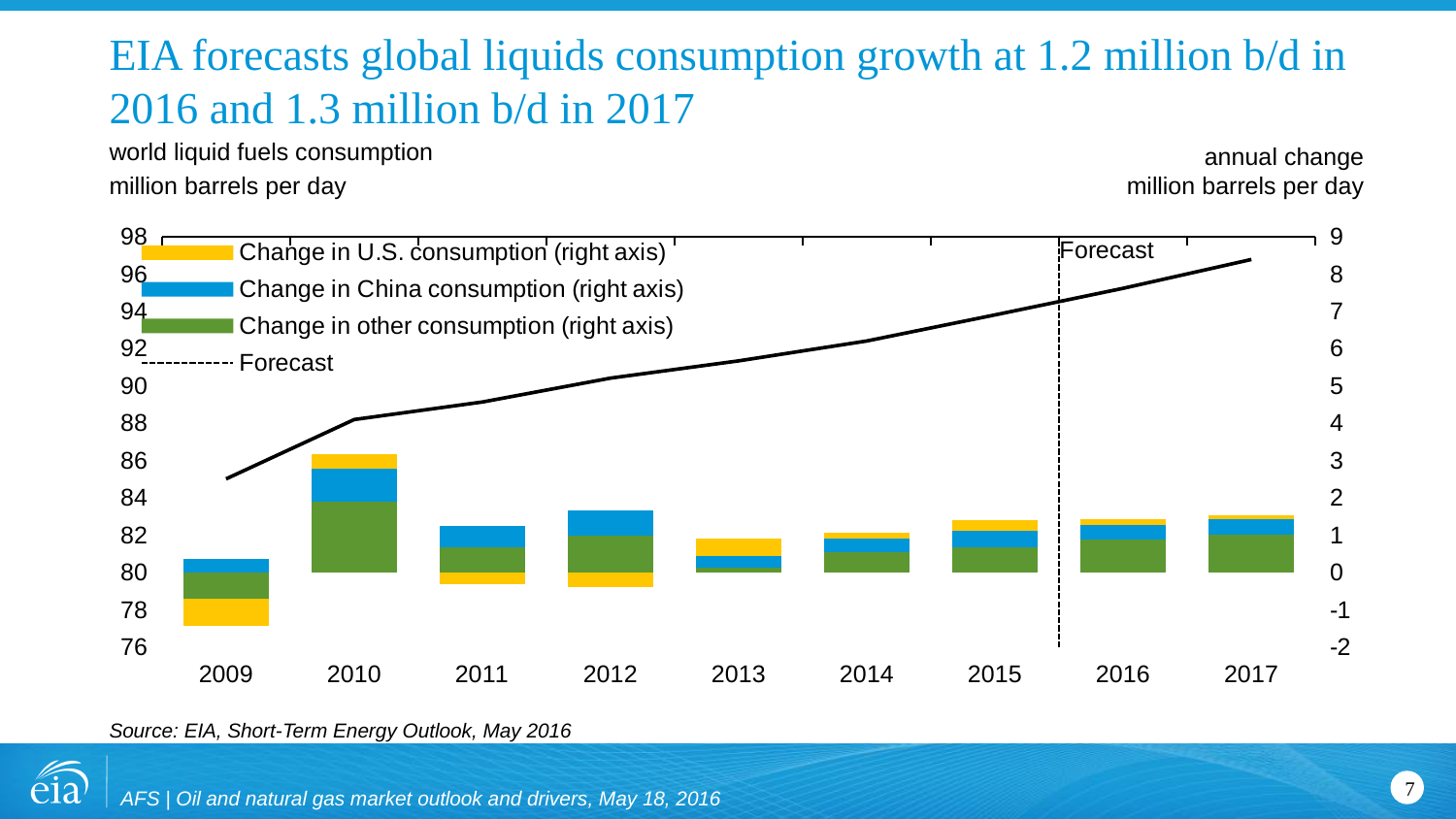
Which year is the only one where the change in U.S. consumption bar is clearly negative and the stacked bar extends below -1 on the right axis? 2009 How many years are shown along the x axis of the chart? 9 Does the world liquid fuels consumption line rise or fall from 2009 to 2017? Rises Is the world liquid fuels consumption line value for 2009 greater or less than 86 million barrels per day? less Which year has the tallest positive stacked bar for annual change in consumption? 2010 Is the world liquid fuels consumption line value for 2017 greater or less than 96 million barrels per day? greater Which years on the chart are marked as forecast years? 2016 and 2017 Which year has the higher world liquid fuels consumption line value, 2011 or 2012? 2012 What kind of chart is shown on the slide? A combination bar and line chart (stacked bars with a line) Is the world liquid fuels consumption line value for 2015 greater or less than 92 million barrels per day? greater How many entries does the chart's legend list? 4